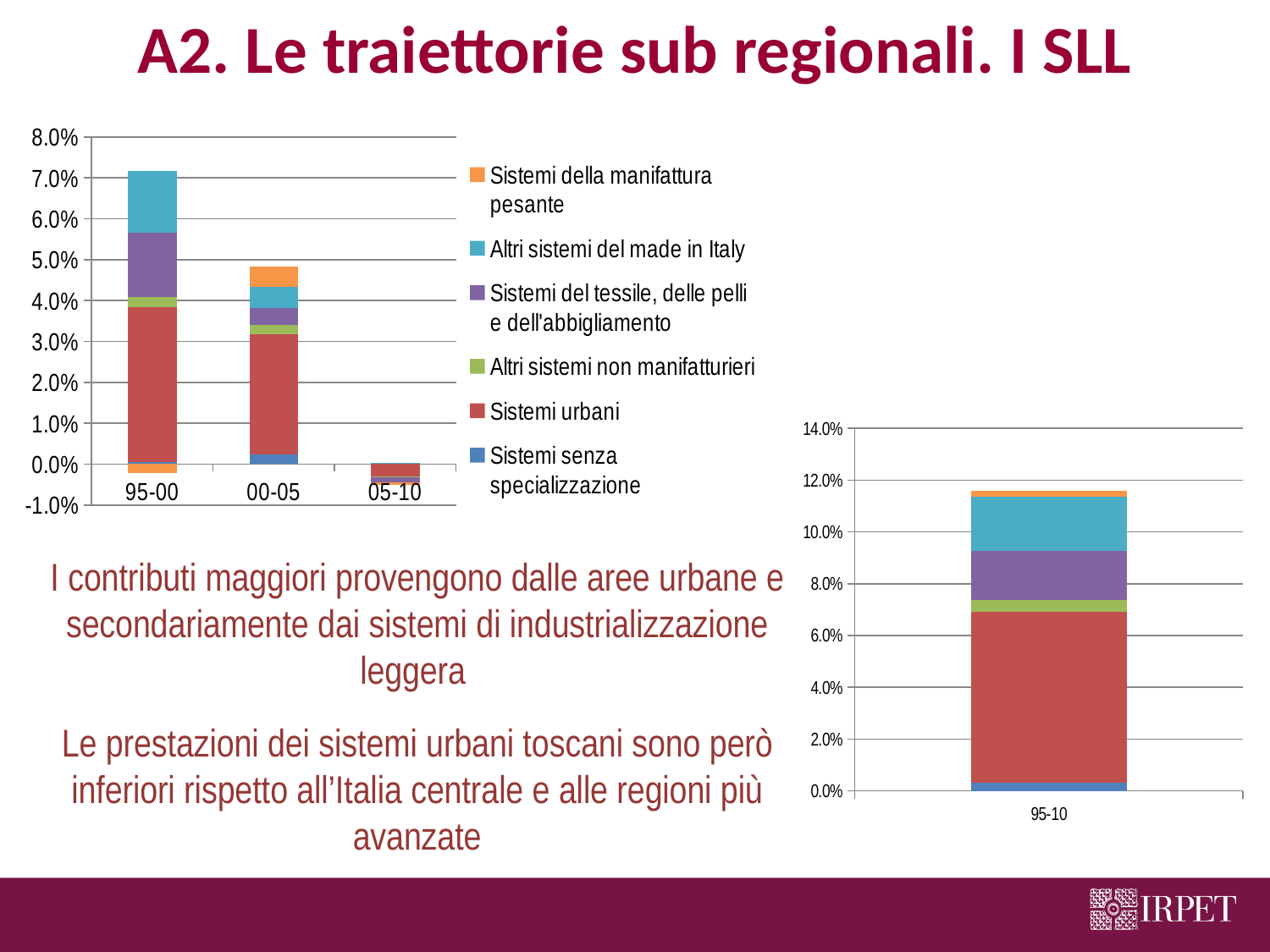
In the left chart's legend, which series is shown in red? Sistemi urbani What is the only category shown on the x axis of the chart on the right of the slide? 95-10 How many periods are shown on the x axis of the left chart? 3 What kind of chart is the chart on the left of the slide? stacked bar chart In the left chart, is the total stacked bar for 95-00 greater or less than 6.0%? greater In the left chart, which period has the shortest stacked bar? 05-10 In the left chart, which stacked bar is taller, 95-00 or 00-05? 95-00 In the left chart, do the total bar heights rise or fall from 95-00 to 05-10? fall In the right chart, is the total height of the 95-10 stacked bar greater or less than 12.0%? less In the left chart, is the total stacked bar for 00-05 greater or less than 5.0%? less In the left chart, which period has the tallest stacked bar? 95-00 How many series does the legend of the left chart list? 6